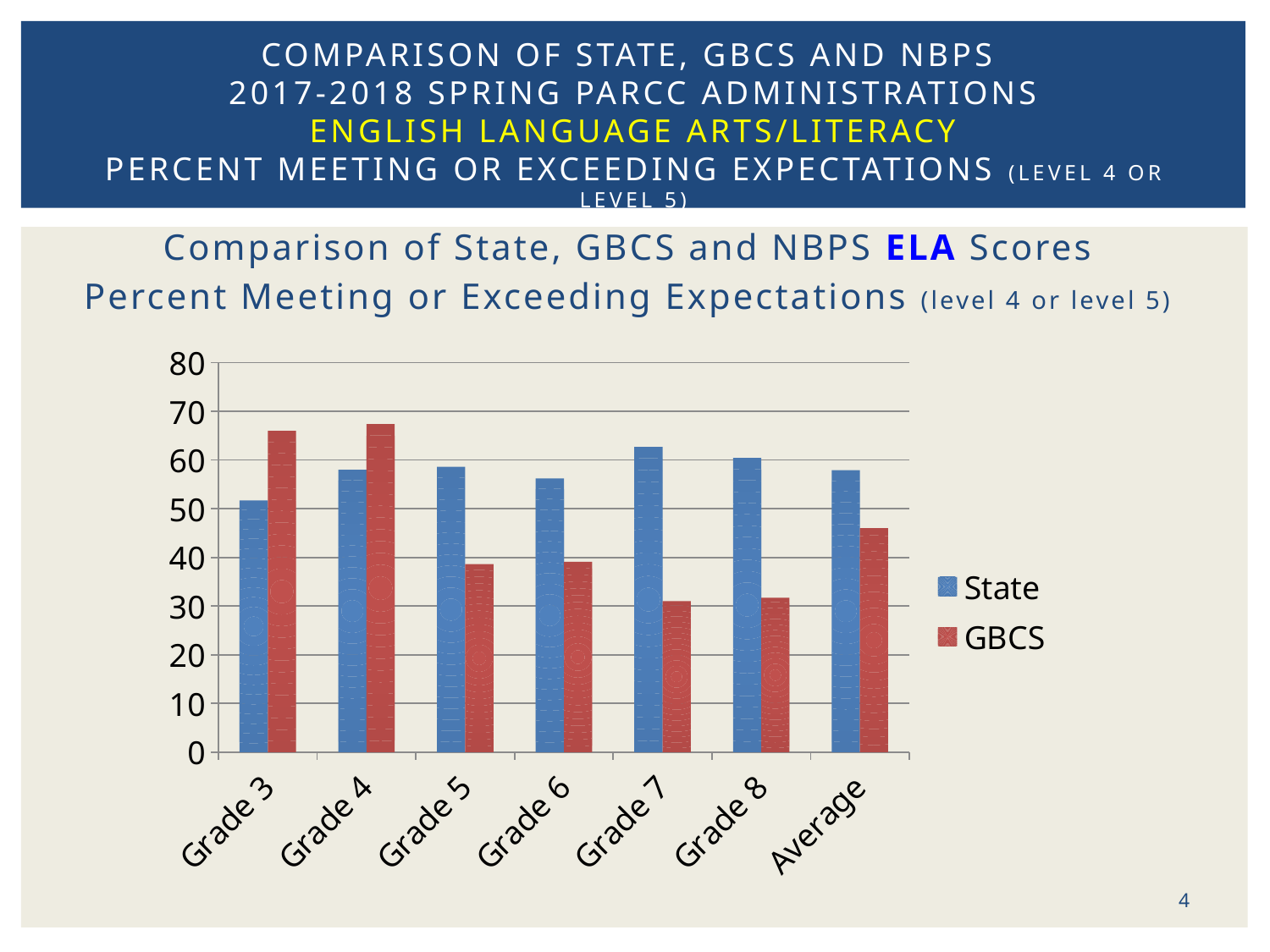
Is the GBCS value for Grade 7 greater or less than 40? less Which colour represents the GBCS series in the chart? red How many series does the legend list? 2 How many categories are shown on the x axis? 7 For Grade 3, which is larger, the State value or the GBCS value? GBCS Which category has the highest State value? Grade 7 Is the GBCS value for Average greater or less than 50? less For Average, which is larger, the State value or the GBCS value? State For Grade 7, which is larger, the State value or the GBCS value? State Is the GBCS value for Grade 3 greater or less than 60? greater What kind of chart is shown on the slide? bar chart Which category has the lowest State value? Grade 3